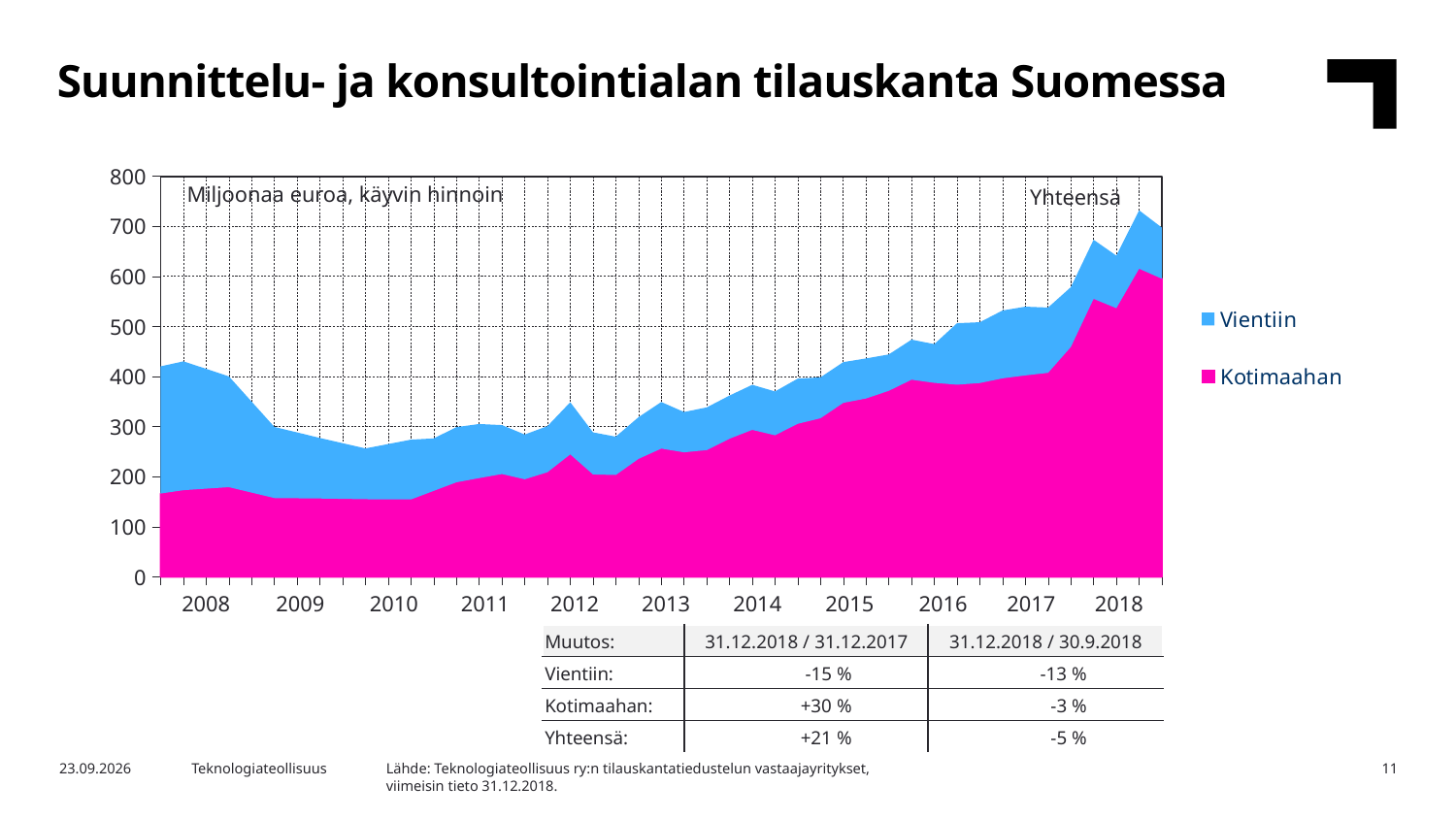
Which two series are listed in the chart legend? Vientiin and Kotimaahan Is the total (Yhteensä) value at the end of 2018 greater or less than 600? greater In which year does the total (Yhteensä) reach its highest level? 2018 What kind of chart is shown on the slide? Stacked area chart Does the Kotimaahan series rise or fall from 2010 to 2018? rise What unit is stated in the chart's label at the top left of the plot area? Miljoonaa euroa, käyvin hinnoin Is the Kotimaahan value at its 2018 peak greater or less than 500? greater Is the total (Yhteensä) value in 2010 greater or less than 300? less How many year labels are shown on the x axis? 11 How many series does the chart legend list? 2 Which series is larger at the end of 2018, Vientiin or Kotimaahan? Kotimaahan